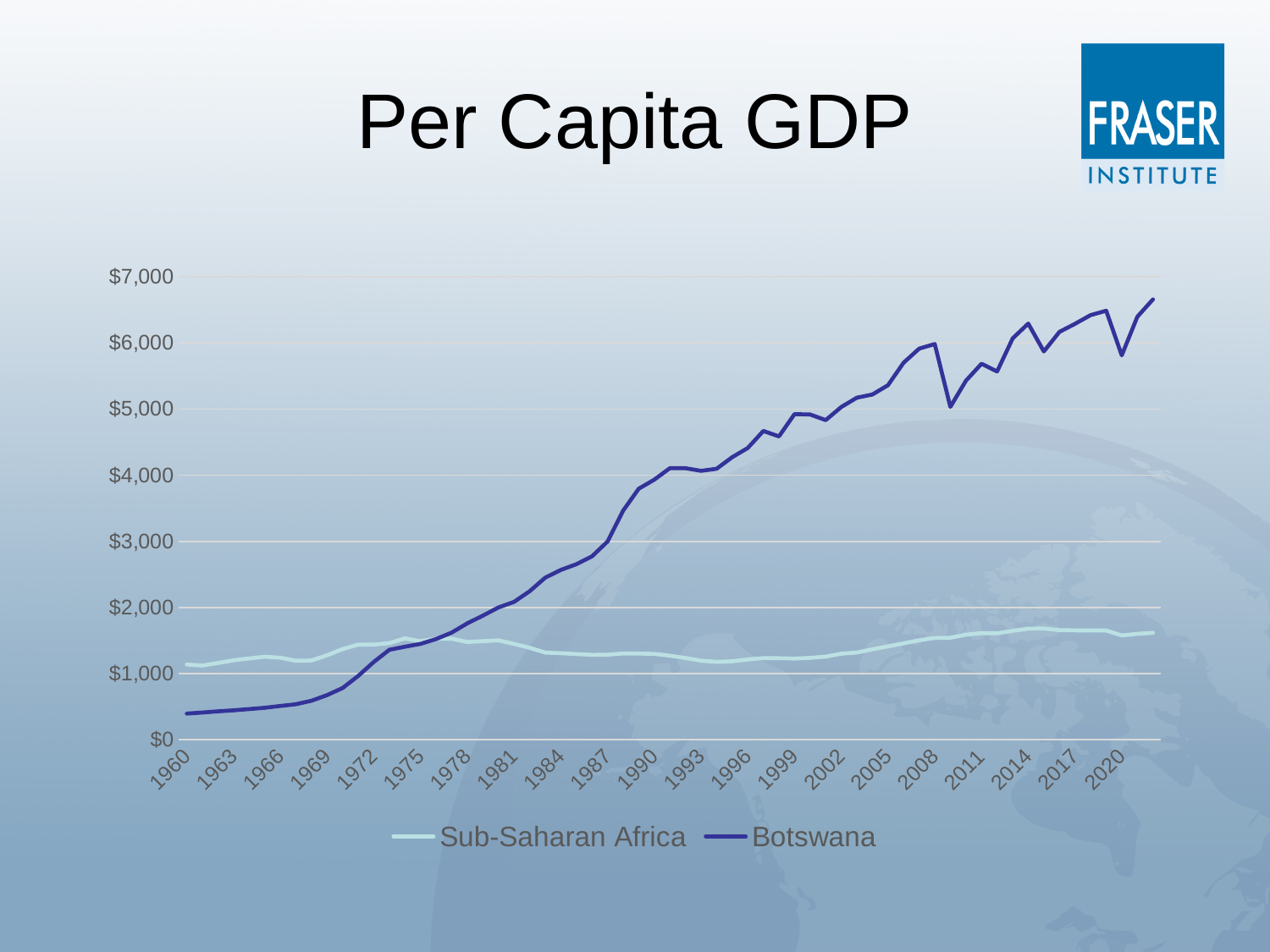
Is the value for Sub-Saharan Africa in 2020 greater or less than $2,000? less Which series has the higher value in 1960, Botswana or Sub-Saharan Africa? Sub-Saharan Africa What is the title of the chart? Per Capita GDP Which series is drawn in dark blue? Botswana How many series does the legend list? 2 What kind of chart is shown on the slide? line chart Is the value for Botswana in 1990 greater or less than $3,000? greater Is the value for Sub-Saharan Africa in 1960 greater or less than $2,000? less Does the Botswana line generally rise or fall from 1960 to 2020? rise Which series has the higher value in 2020, Botswana or Sub-Saharan Africa? Botswana